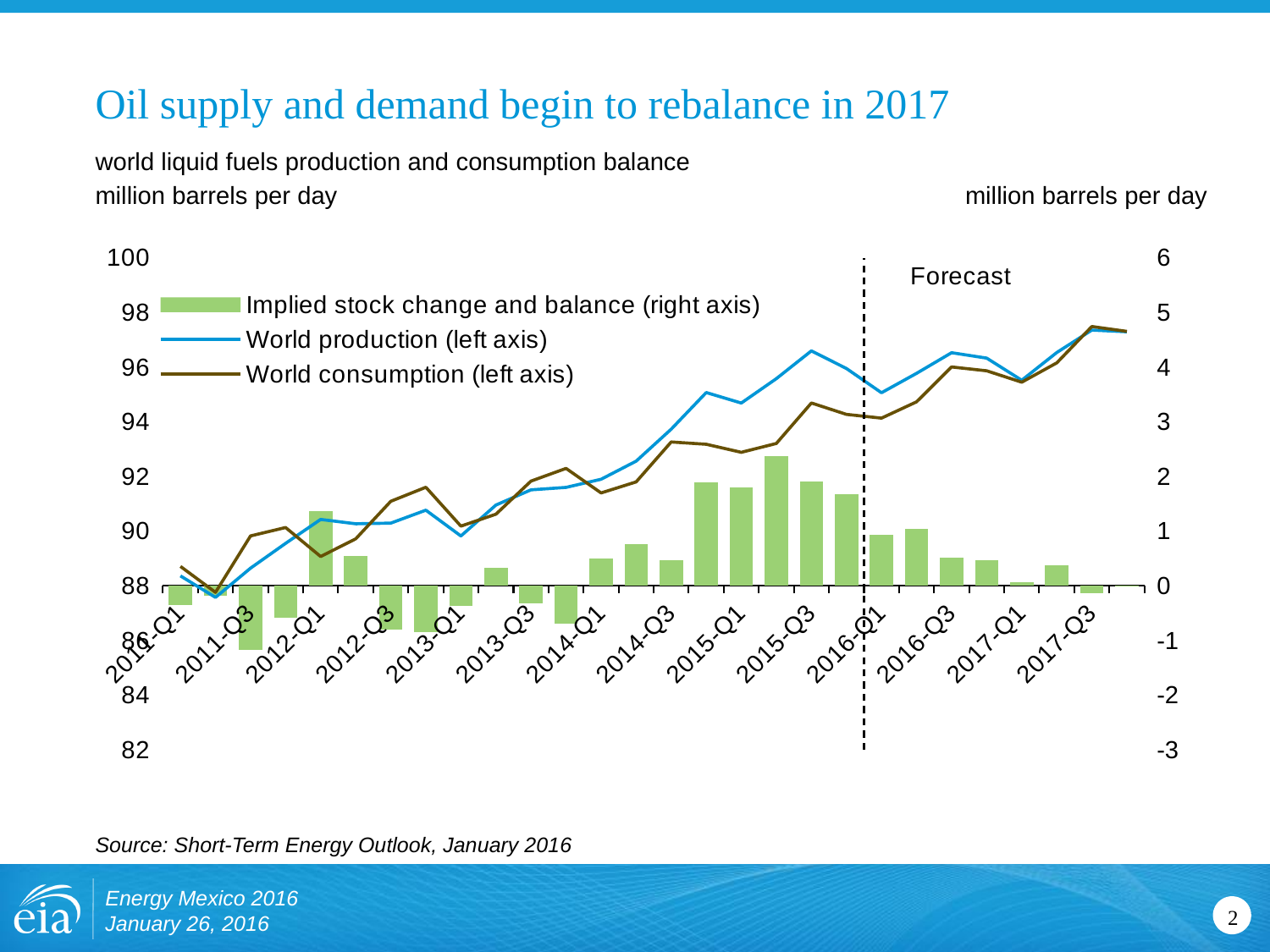
What kind of chart is shown on the slide? Combination bar and line chart How many quarter labels are shown on the x axis? 14 At 2012-Q3, which is higher: World production or World consumption? World consumption Is the Implied stock change and balance value at 2013-Q1 greater or less than 0? less Which series is plotted on the right axis according to the legend? Implied stock change and balance Is the World consumption value at 2014-Q1 greater or less than 92? less Is the World production value at 2015-Q3 greater or less than 96? greater How many series does the chart legend list? 3 What is the title of the chart on the slide? Oil supply and demand begin to rebalance in 2017 At 2015-Q3, which is higher: World production or World consumption? World production Does World consumption generally rise or fall from 2011-Q1 to 2017-Q3? rise